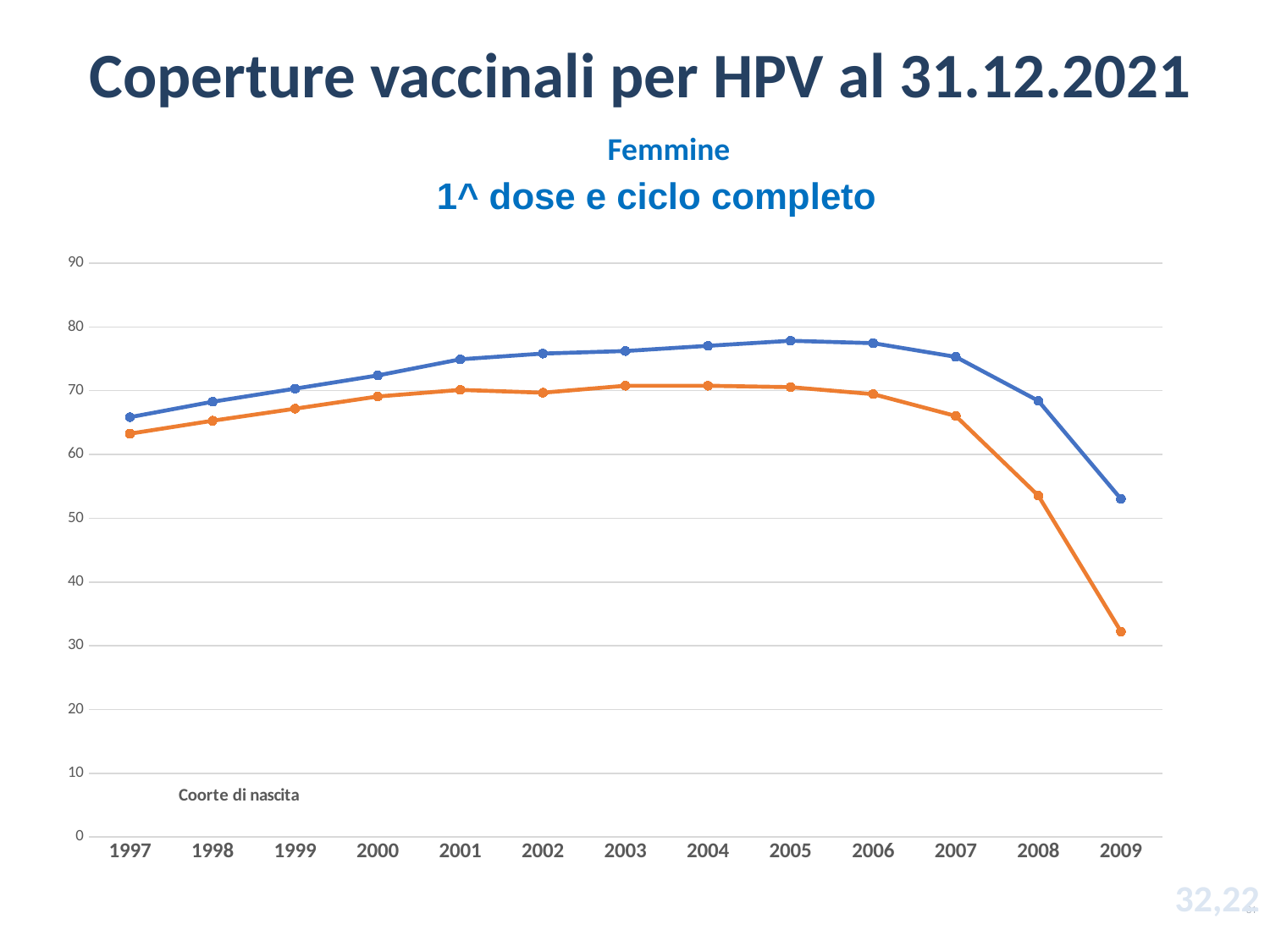
Is the value of the orange line for the 2009 cohort greater or less than 40? less For the 2009 cohort, which line has the higher value, the blue or the orange? blue For which birth cohort is the orange line at its lowest value? 2009 How many birth cohorts are plotted along the x axis? 13 Is the value of the orange line for the 2008 cohort greater or less than 60? less Is the value of the blue line for the 2009 cohort greater or less than 50? greater Do the values of the orange line rise or fall from the 2007 cohort to the 2009 cohort? fall For which birth cohort is the blue line at its lowest value? 2009 What label is shown for the x axis of the chart? Coorte di nascita What kind of chart is shown on the slide? line chart